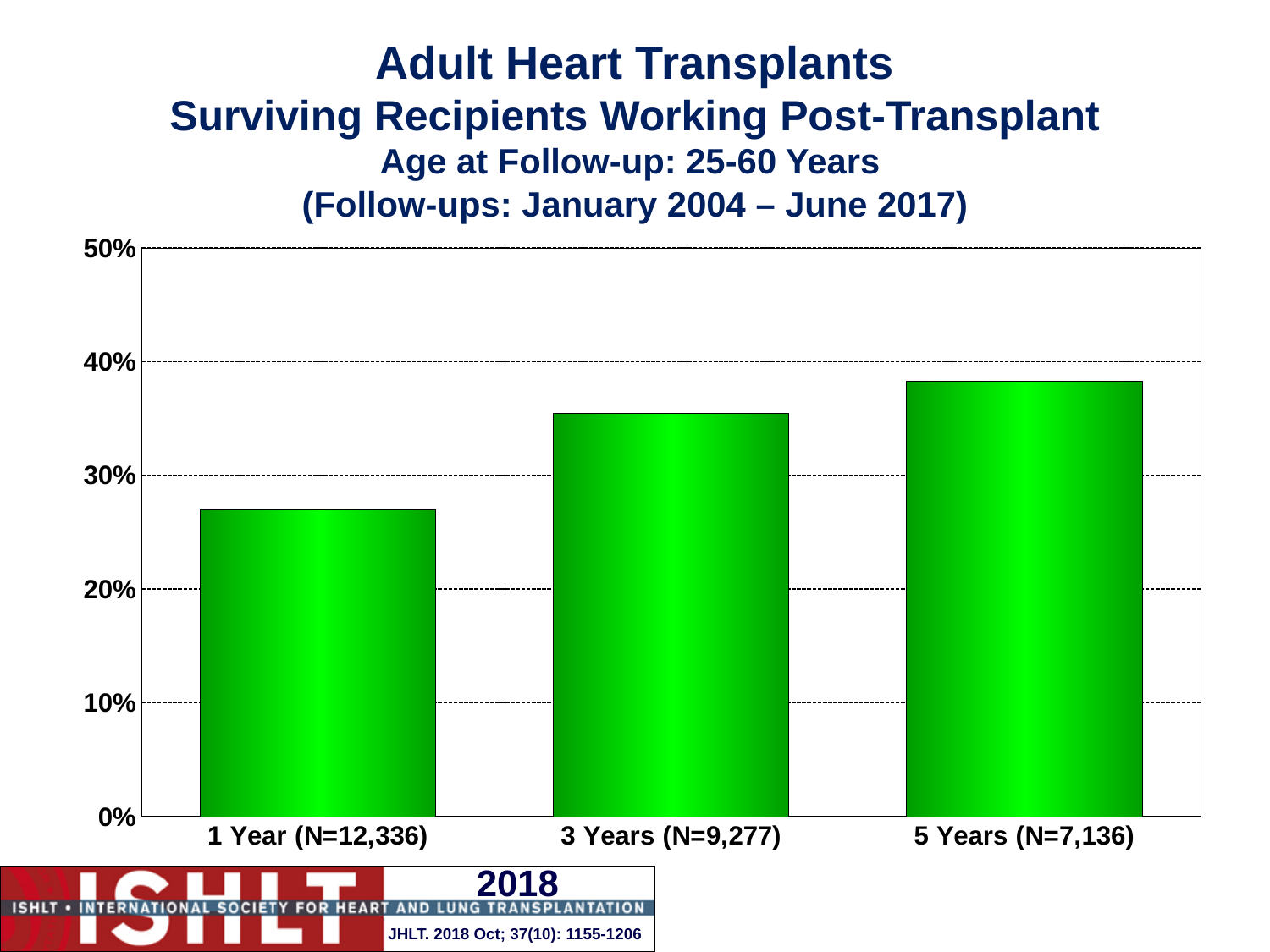
Is the value for 1 Year greater or less than 20%? greater Which follow-up time point has the lowest percentage of surviving recipients working post-transplant? 1 Year (N=12,336) Which follow-up time point has the highest percentage of surviving recipients working post-transplant? 5 Years (N=7,136) Is the value for 1 Year greater or less than 30%? less Is the value for 5 Years greater or less than 40%? less Do the values rise or fall as the follow-up time increases from 1 Year to 5 Years? rise What is the N (number of recipients) shown for the 1 Year category? N=12,336 How many categories (follow-up time points) are plotted on the chart? 3 What kind of chart is shown on the slide? Bar chart Which is larger, the value for 3 Years or the value for 5 Years? 5 Years What age range at follow-up does the chart title specify? 25-60 Years